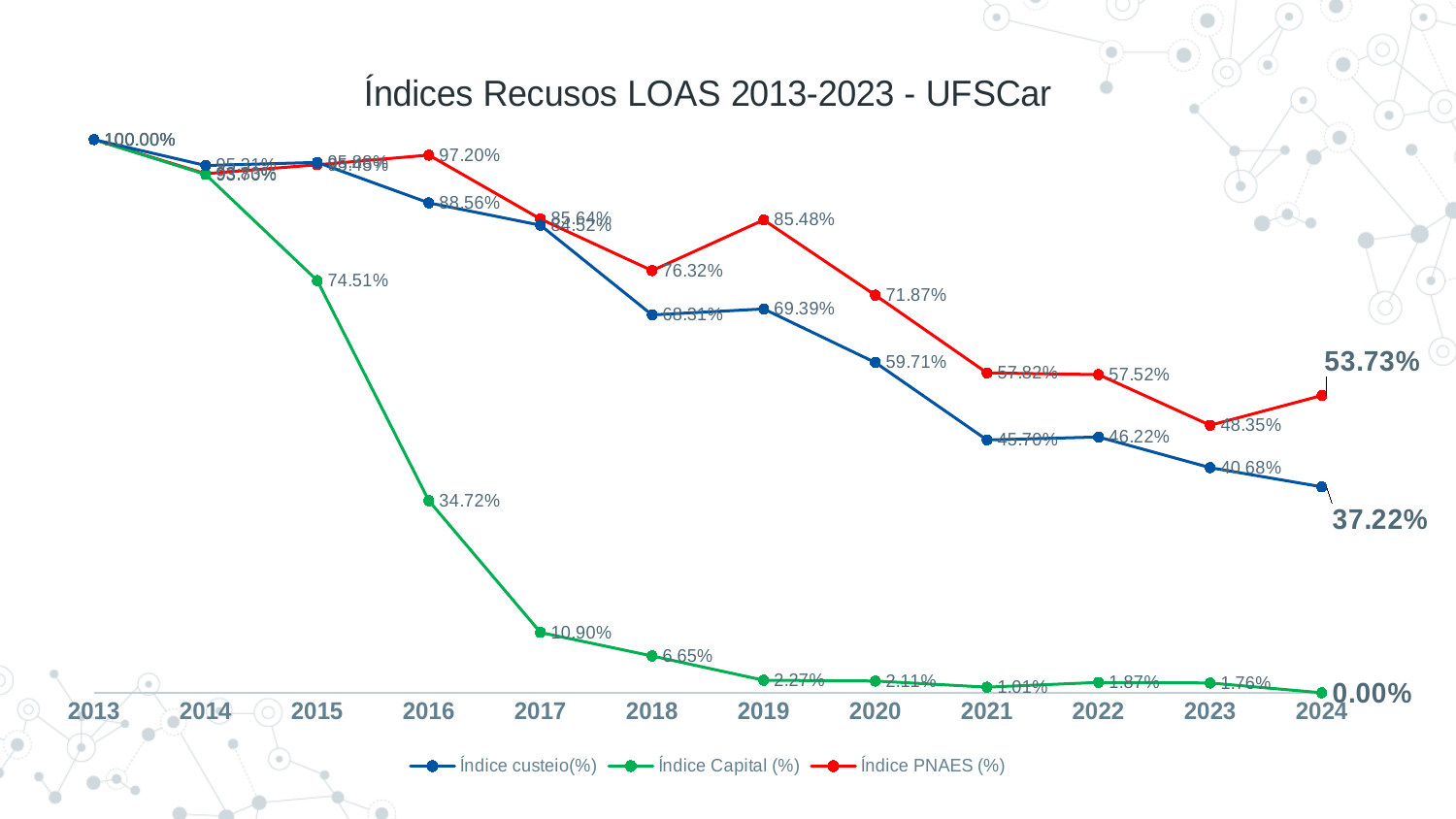
What is the value of Índice Capital (%) in 2016? 34.72% How many series does the legend list? 3 Does the Índice Capital (%) series rise or fall from 2013 to 2024? fall In 2019, which is larger: Índice PNAES (%) or Índice custeio(%)? Índice PNAES (%) What is the value of Índice PNAES (%) in 2016? 97.20% What is the difference between Índice PNAES (%) and Índice custeio(%) in 2024? 16.51% What is the value of Índice custeio(%) in 2024? 37.22% How many years are shown on the x axis? 12 What is the value of Índice PNAES (%) in 2024? 53.73% What is the value of Índice Capital (%) in 2024? 0.00% What kind of chart is shown on the slide? line chart What is the value of Índice Capital (%) in 2017? 10.90%